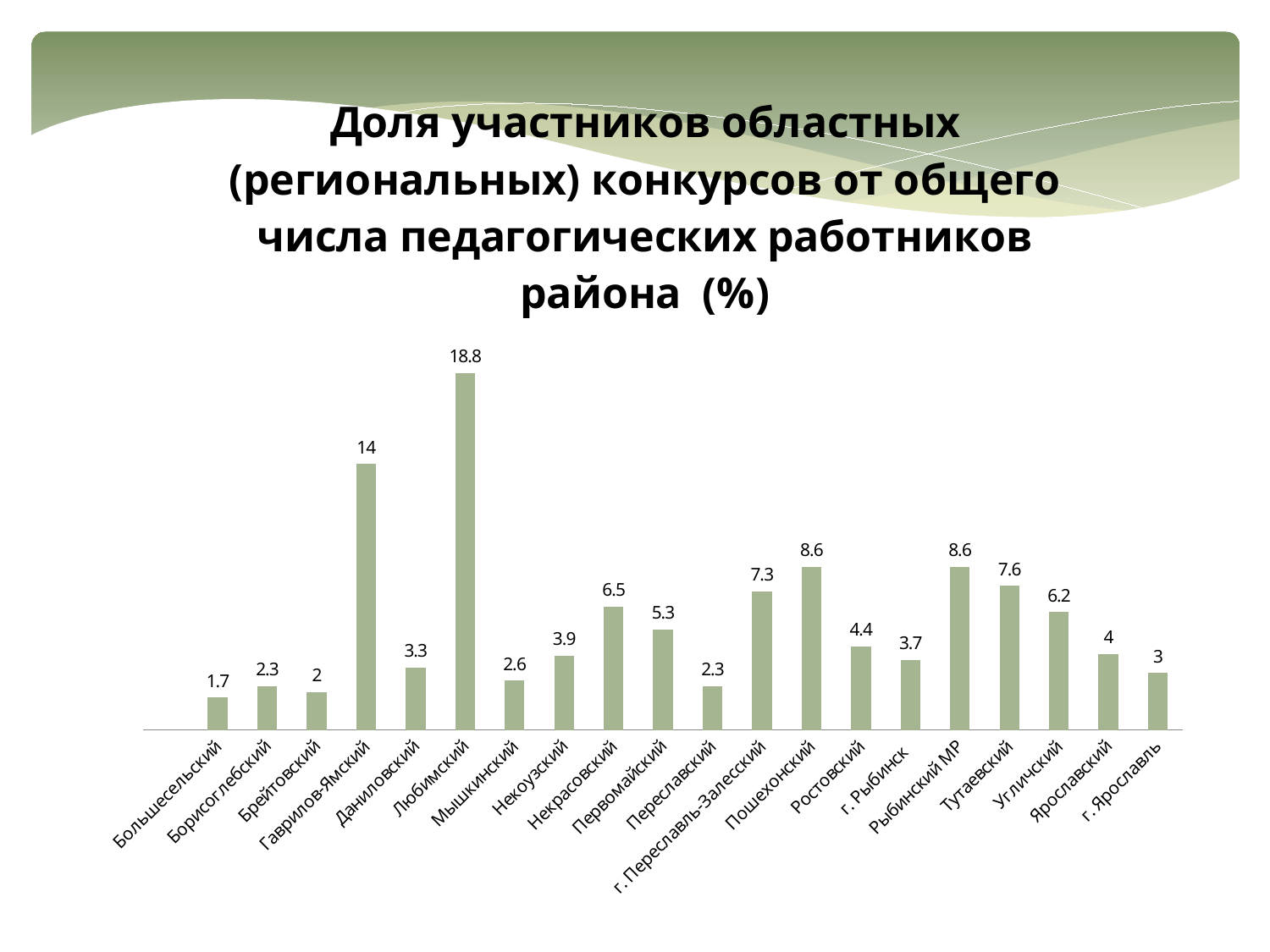
What is the value for Любимский? 18.8 Which district has the highest value? Любимский Which district has the lowest value? Большесельский What is the value for Гаврилов-Ямский? 14 How many districts are shown on the chart? 20 What is the value for Угличский? 6.2 What is the difference between the values for Любимский and Гаврилов-Ямский? 4.8 Which two districts share the value 8.6? Пошехонский and Рыбинский МР What kind of chart is shown on the slide? Bar chart What is the value for г. Рыбинск? 3.7 Which is larger, the value for Некрасовский or the value for Первомайский? Некрасовский What is the difference between the values for Тутаевский and Ростовский? 3.2